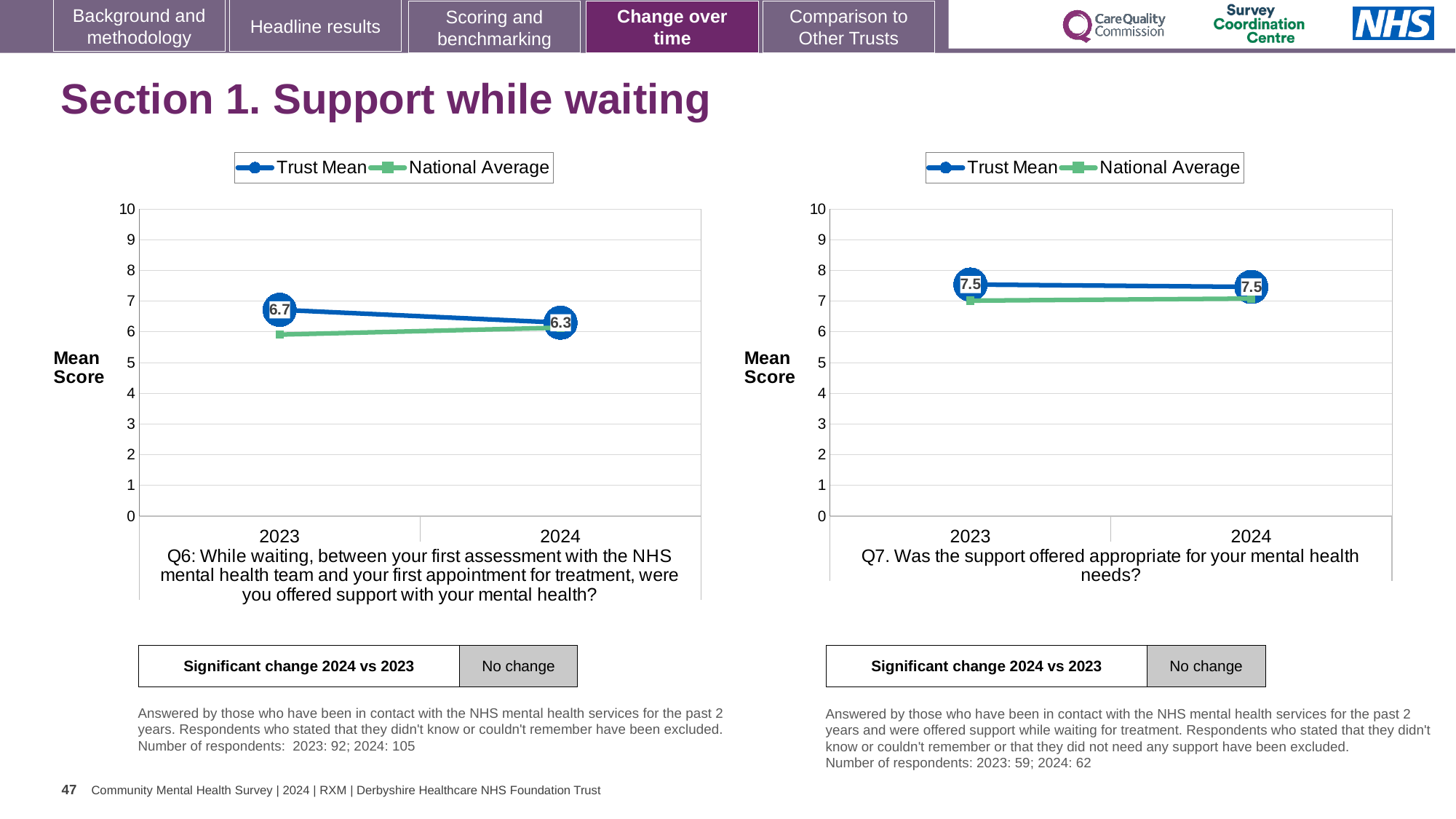
How many series does the legend of the left chart (Q6) list? 2 In the right chart (Q7), what is the Trust Mean for 2024? 7.5 In the right chart (Q7), is the National Average for 2023 greater or less than 8? less In the left chart (Q6), what is the Trust Mean for 2023? 6.7 In the right chart (Q7), does the Trust Mean rise, fall or stay the same from 2023 to 2024? stays the same In the left chart (Q6), what is the Trust Mean for 2024? 6.3 In the left chart (Q6), by how much did the Trust Mean change from 2023 to 2024? 0.4 In the left chart (Q6), which is higher in 2023, the Trust Mean or the National Average? Trust Mean In the right chart (Q7), which is higher in 2023, the Trust Mean or the National Average? Trust Mean How many years are plotted on the x axis of the right chart (Q7)? 2 In the left chart (Q6), does the Trust Mean rise or fall from 2023 to 2024? fall What kind of chart is the left chart (Q6)? line chart